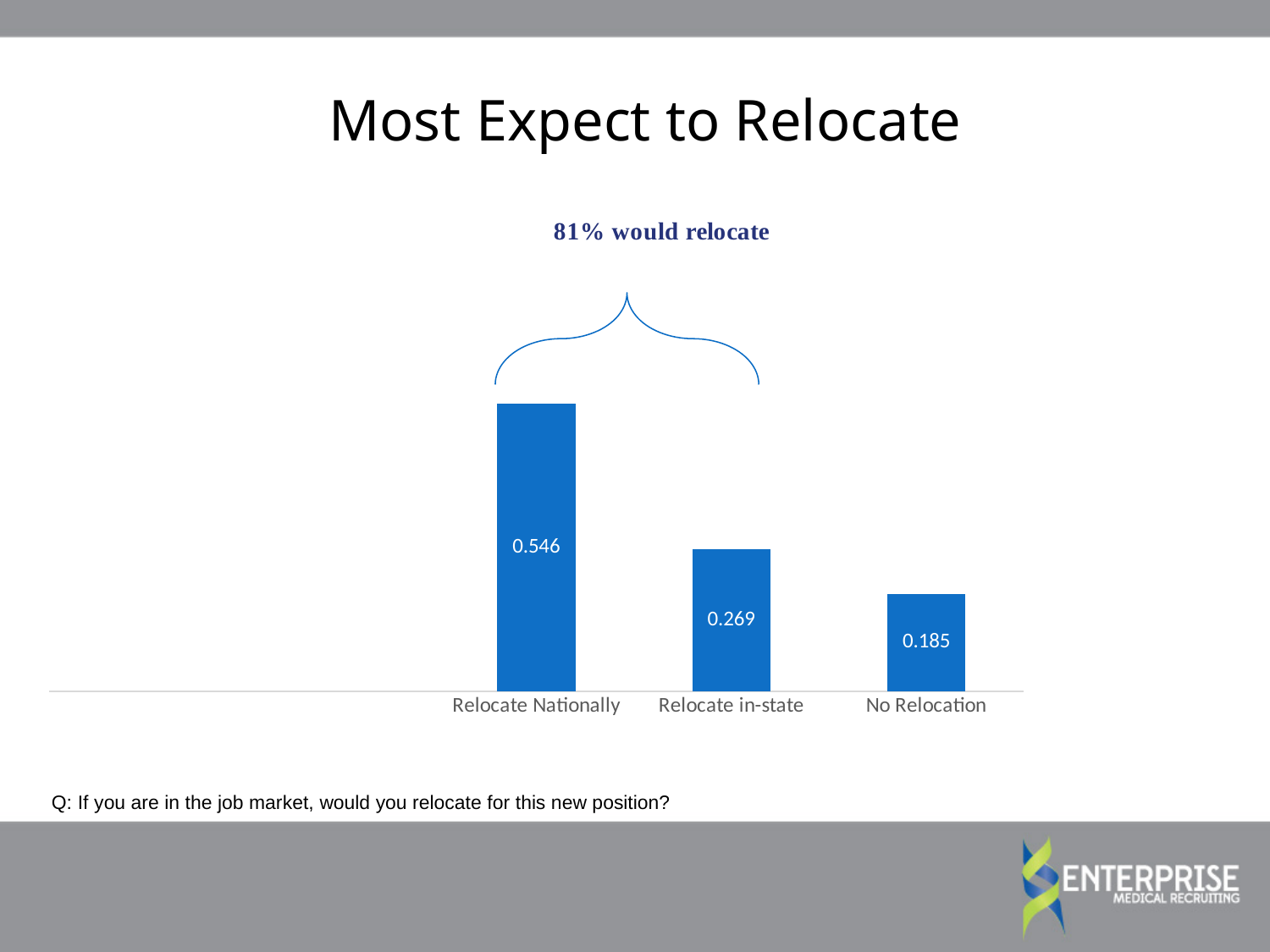
What is the title of the slide? Most Expect to Relocate What kind of chart is shown on the slide? Bar chart Which category has the lowest value? No Relocation Do the values rise or fall from left to right across the categories? Fall What is the value for Relocate Nationally? 0.546 What is the value for Relocate in-state? 0.269 What is the difference between the values for Relocate in-state and No Relocation? 0.084 What is the value for No Relocation? 0.185 How many categories are shown in the chart? 3 Which category has the highest value? Relocate Nationally What is the difference between the values for Relocate Nationally and Relocate in-state? 0.277 Which is larger, the value for Relocate in-state or the value for No Relocation? Relocate in-state